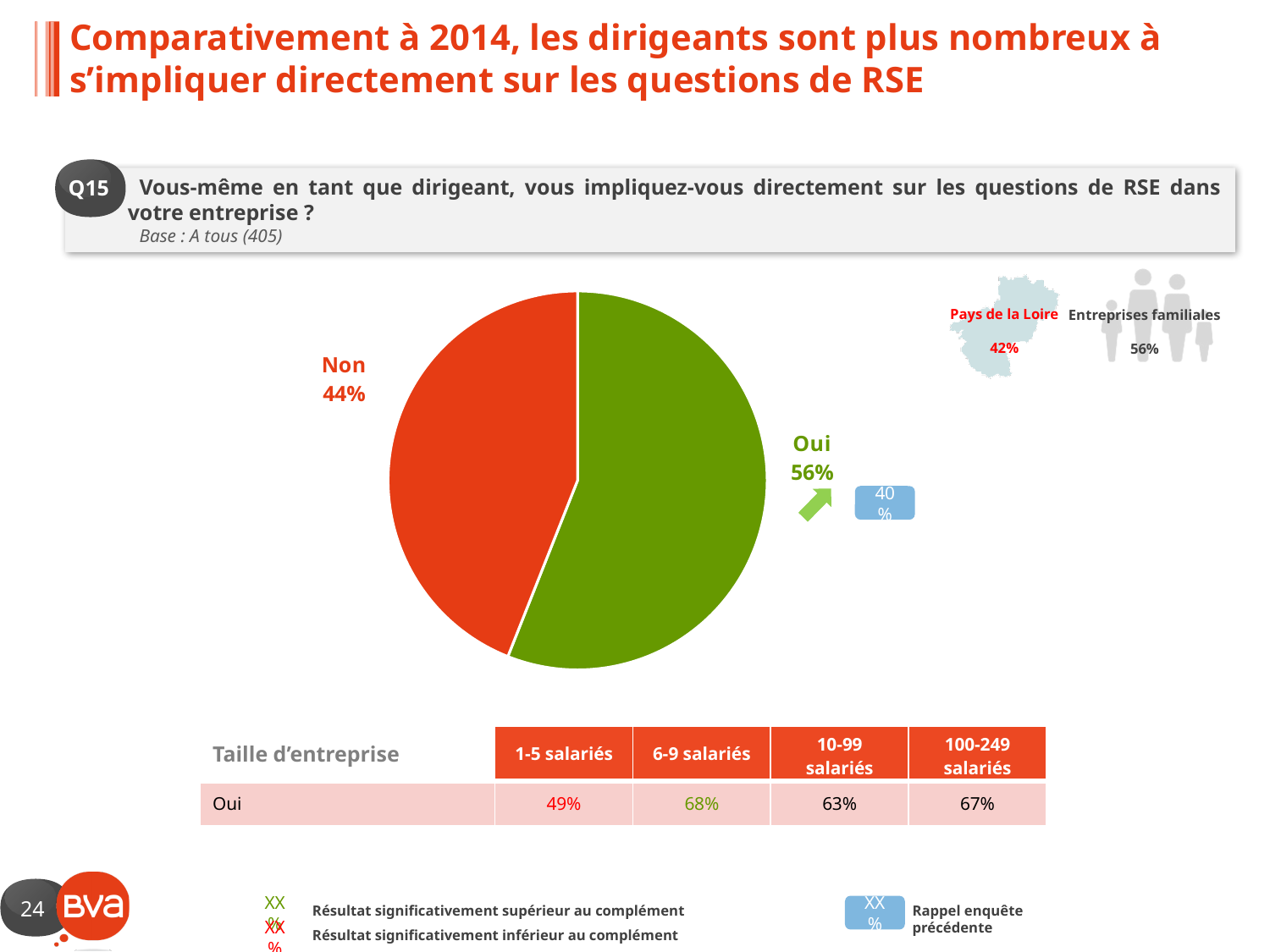
What colour is the "Non" slice of the pie chart? red What is the difference between the "Oui" and "Non" shares in the pie chart? 12% Which slice of the pie chart is the largest? Oui What colour is the "Oui" slice of the pie chart? green Which slice of the pie chart is the smallest? Non What share of the pie does the "Oui" slice represent? 56% Is the value for "Oui" in the pie chart greater or less than 50%? greater What kind of chart is shown on the slide? pie chart How many slices does the pie chart have? 2 What share of the pie does the "Non" slice represent? 44% What is the total of the two slices in the pie chart? 100% Which is larger in the pie chart, "Oui" or "Non"? Oui